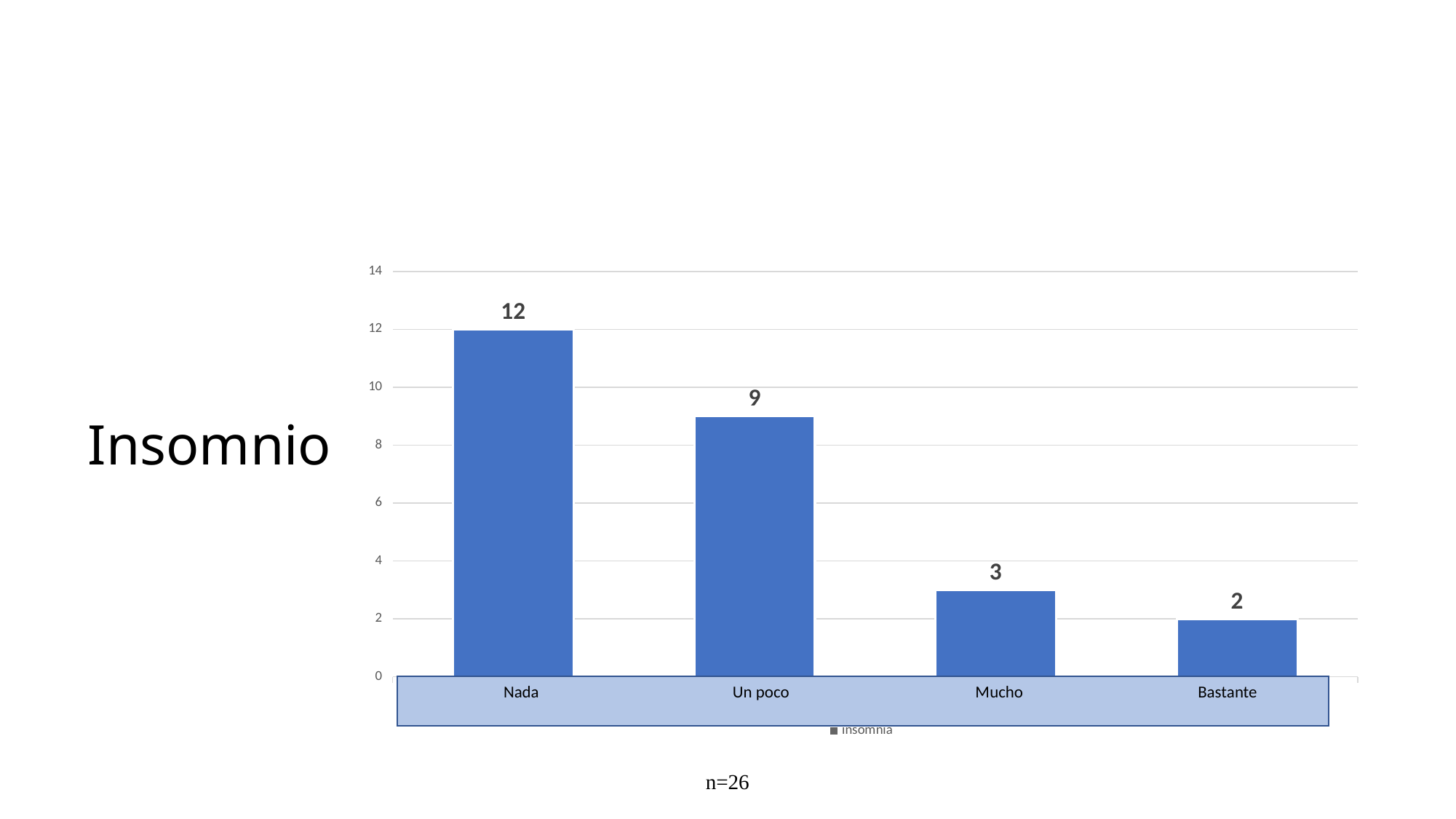
What is the value for Bastante? 2 What kind of chart is shown on the slide? bar chart Do the values rise or fall from left to right along the x axis? fall What is the value for Mucho? 3 Which is larger, the value for Mucho or the value for Bastante? Mucho What is the difference between the values for Nada and Un poco? 3 Which category has the highest value? Nada What is the value for Un poco? 9 Which category has the lowest value? Bastante What is the value for Nada? 12 How many categories are shown on the x axis? 4 Is the value for Un poco greater or less than 10? less